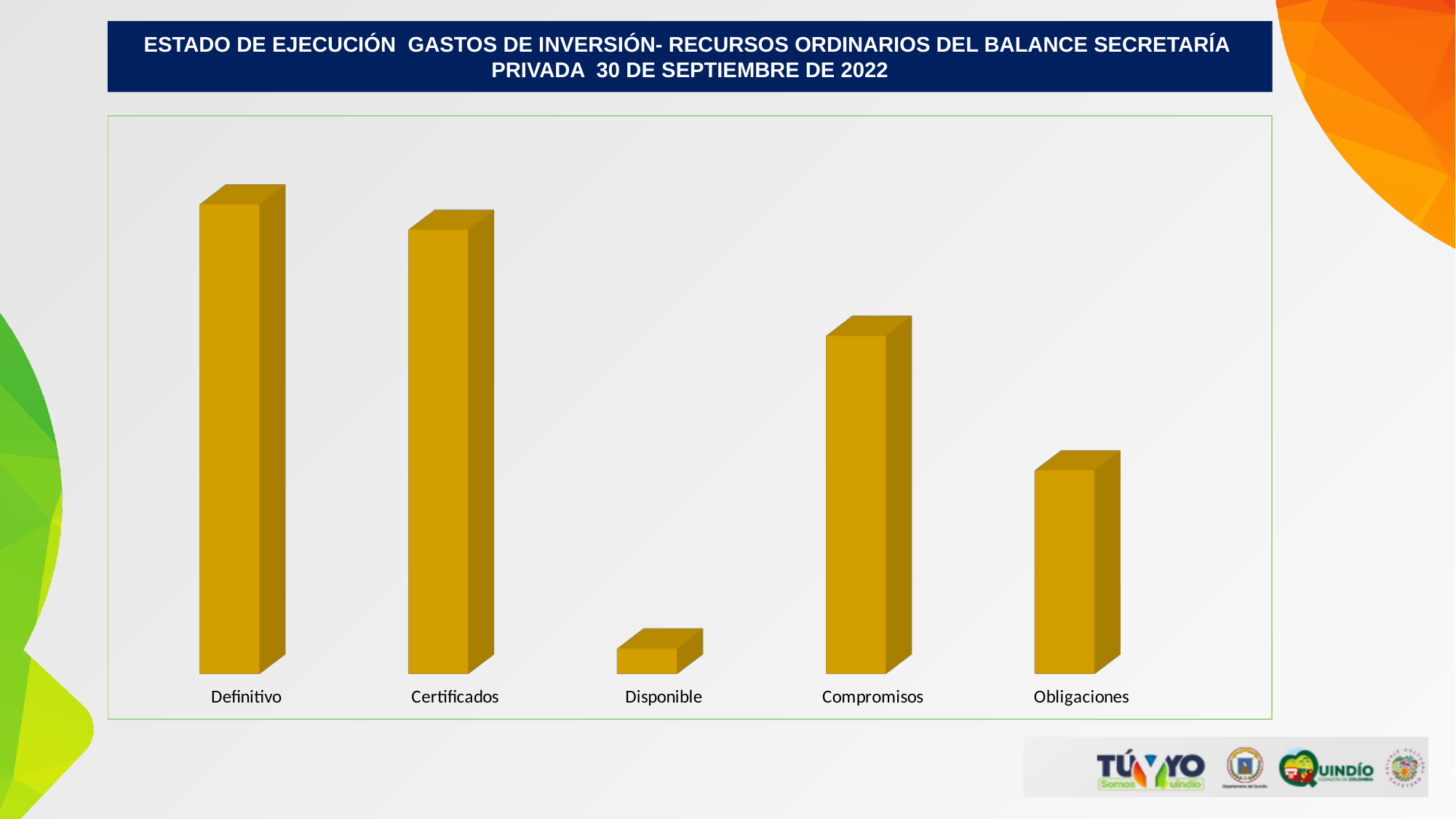
What colour are the bars in the chart? Gold (yellow-orange) Which category has the highest bar? Definitivo What kind of chart is shown on the slide? Bar chart Which is larger, the bar for Certificados or the bar for Compromisos? Certificados Which is larger, the bar for Disponible or the bar for Obligaciones? Obligaciones Which category has the lowest bar? Disponible Which is larger, the bar for Definitivo or the bar for Certificados? Definitivo What is the label of the third category from the left on the x axis? Disponible How many categories are plotted in the chart? 5